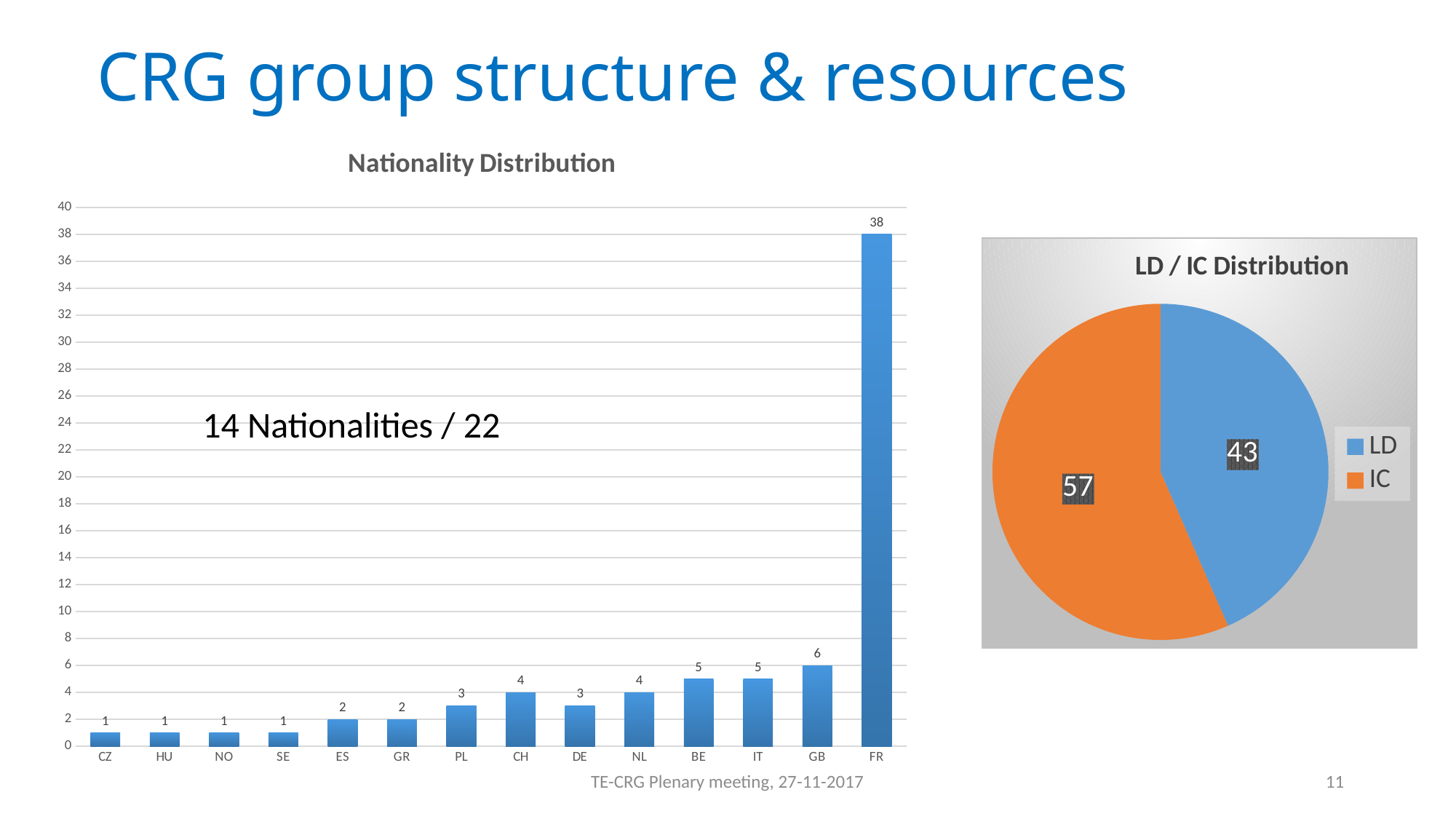
In the Nationality Distribution chart, do the values generally rise or fall from left to right along the x axis? rise In the LD / IC Distribution chart, what is the value for LD? 43 In the Nationality Distribution chart, what is the value for GB? 6 In the Nationality Distribution chart, which nationality has the highest value? FR What kind of chart is the Nationality Distribution chart? bar chart What kind of chart is the LD / IC Distribution chart? pie chart In the Nationality Distribution chart, what is the difference between the values for FR and GB? 32 In the Nationality Distribution chart, which is larger, the value for BE or the value for DE? BE In the Nationality Distribution chart, how many nationality categories are shown on the x axis? 14 In the Nationality Distribution chart, what is the value for FR? 38 In the LD / IC Distribution chart, which slice is larger, LD or IC? IC In the LD / IC Distribution chart, what is the value for IC? 57